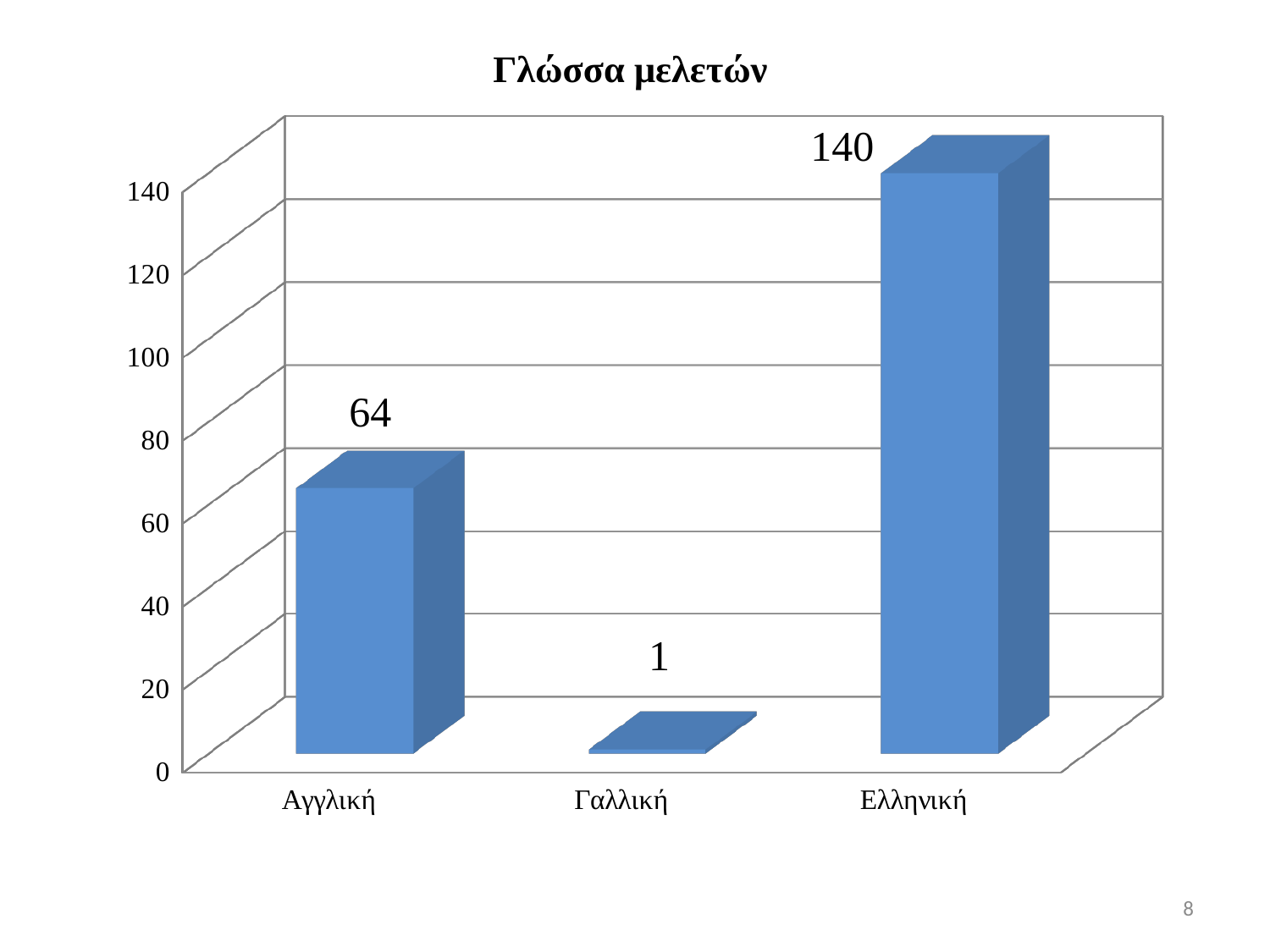
What kind of chart is shown on the slide? bar chart What is the difference between the values for Ελληνική and Αγγλική? 76 What is the value for Ελληνική? 140 How many categories are shown on the x axis? 3 What is the value for Γαλλική? 1 Which category has the highest value? Ελληνική Which category has the lowest value? Γαλλική What is the value for Αγγλική? 64 What is the title of the chart? Γλώσσα μελετών Which is larger, the value for Αγγλική or the value for Γαλλική? Αγγλική What is the difference between the values for Αγγλική and Γαλλική? 63 Is the value for Αγγλική greater or less than 80? less